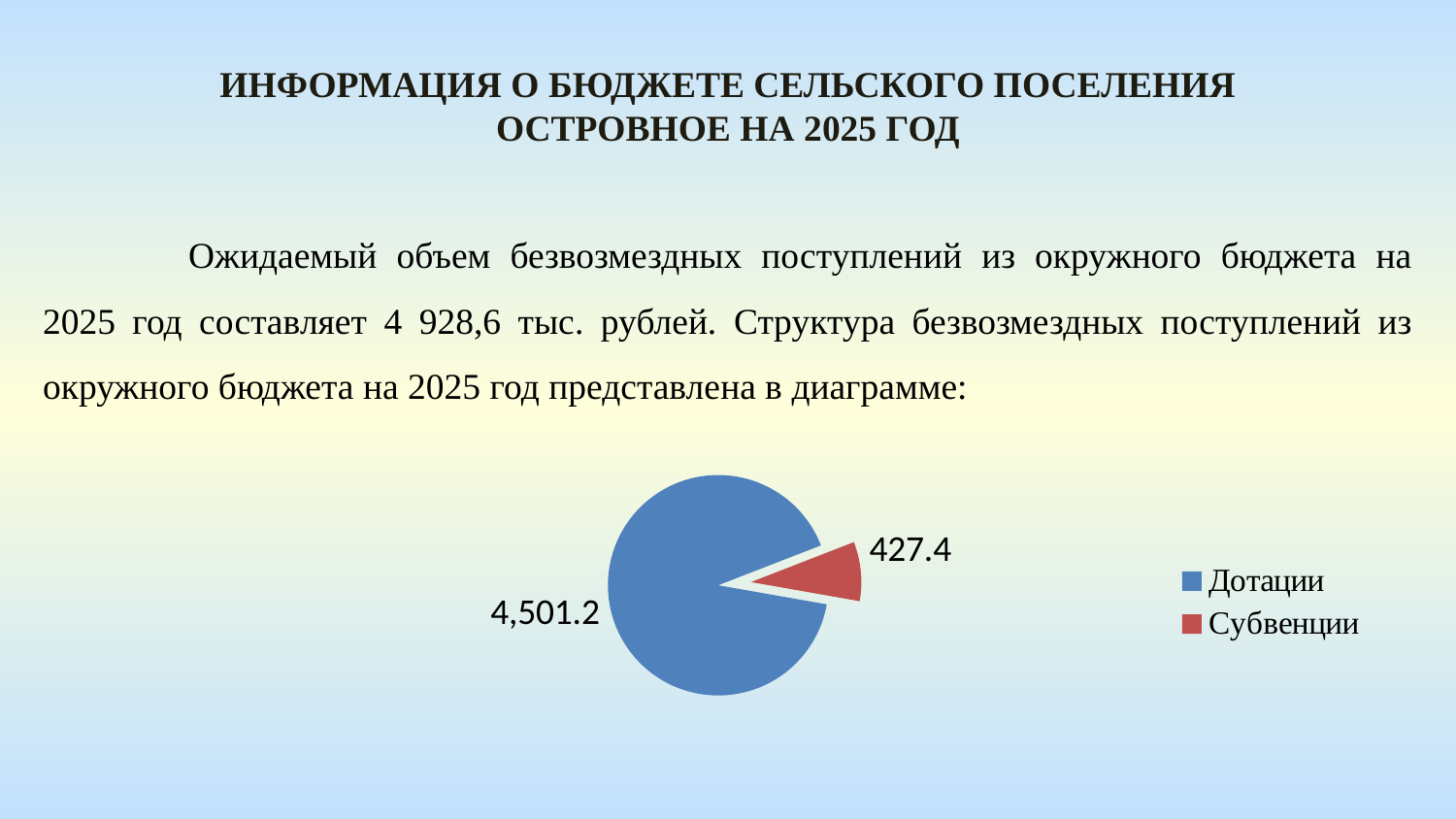
What is the value shown for Субвенции in the pie chart? 427.4 Which category has the largest slice in the pie chart? Дотации What is the total of the two values shown in the pie chart? 4,928.6 What is the value shown for Дотации in the pie chart? 4,501.2 How many entries does the legend list? 2 Which is larger, the value for Дотации or the value for Субвенции? Дотации What colour is the Субвенции slice in the pie chart? Red What is the difference between the values for Дотации and Субвенции? 4,073.8 What kind of chart is shown on the slide? Pie chart How many slices does the pie chart have? 2 Which category has the smallest slice in the pie chart? Субвенции